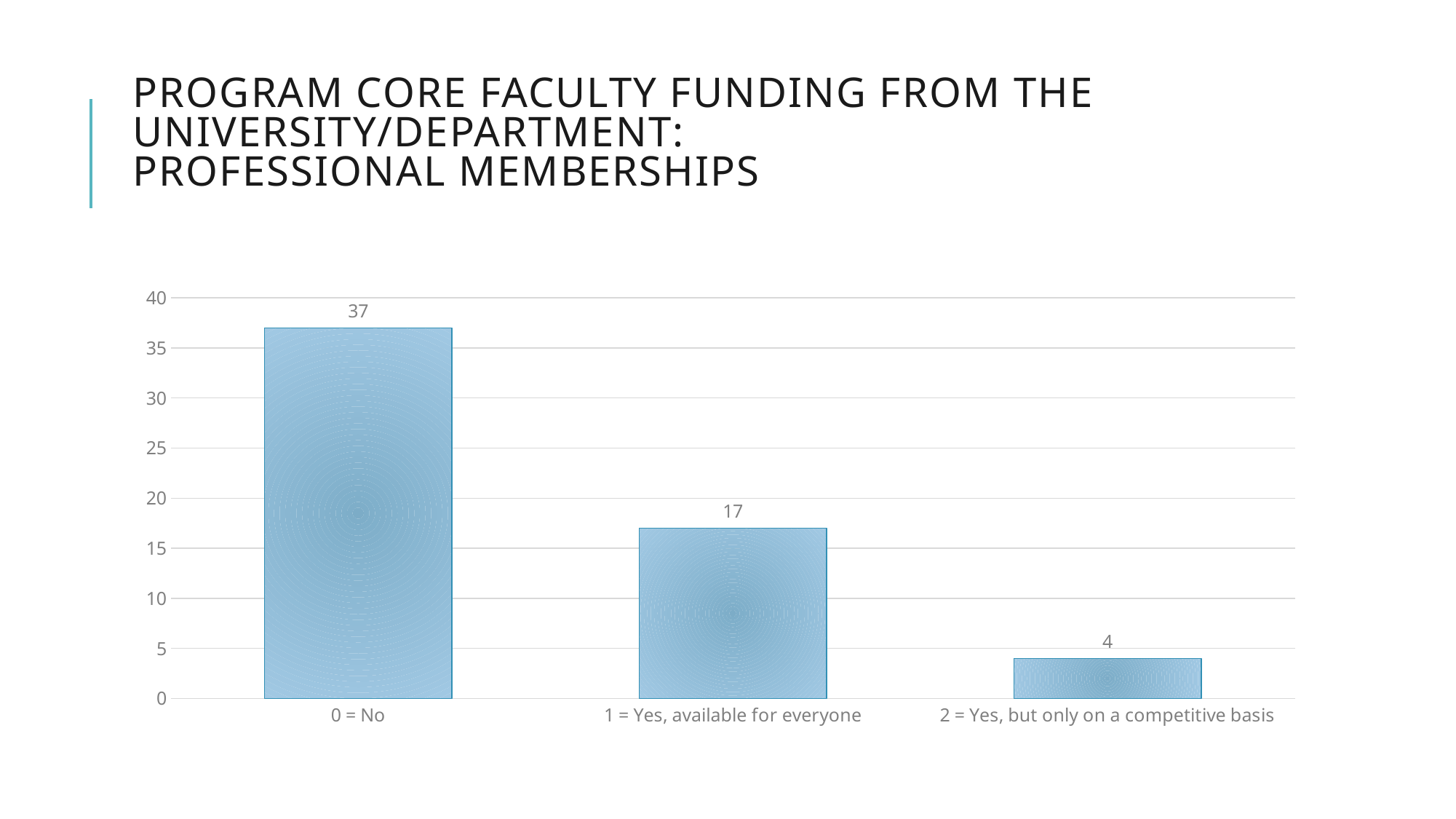
Which category has the lowest value? 2 = Yes, but only on a competitive basis What is the value for "1 = Yes, available for everyone"? 17 What is the difference between the values for "0 = No" and "1 = Yes, available for everyone"? 20 Do the values rise or fall from left to right along the x axis? fall Which is larger: the value for "1 = Yes, available for everyone" or the value for "2 = Yes, but only on a competitive basis"? 1 = Yes, available for everyone What is the difference between the values for "1 = Yes, available for everyone" and "2 = Yes, but only on a competitive basis"? 13 What is the value for "2 = Yes, but only on a competitive basis"? 4 Is the value for "0 = No" greater or less than 35? greater What is the value for "0 = No"? 37 Which category has the highest value? 0 = No How many categories are shown on the x axis? 3 What kind of chart is shown on the slide? bar chart